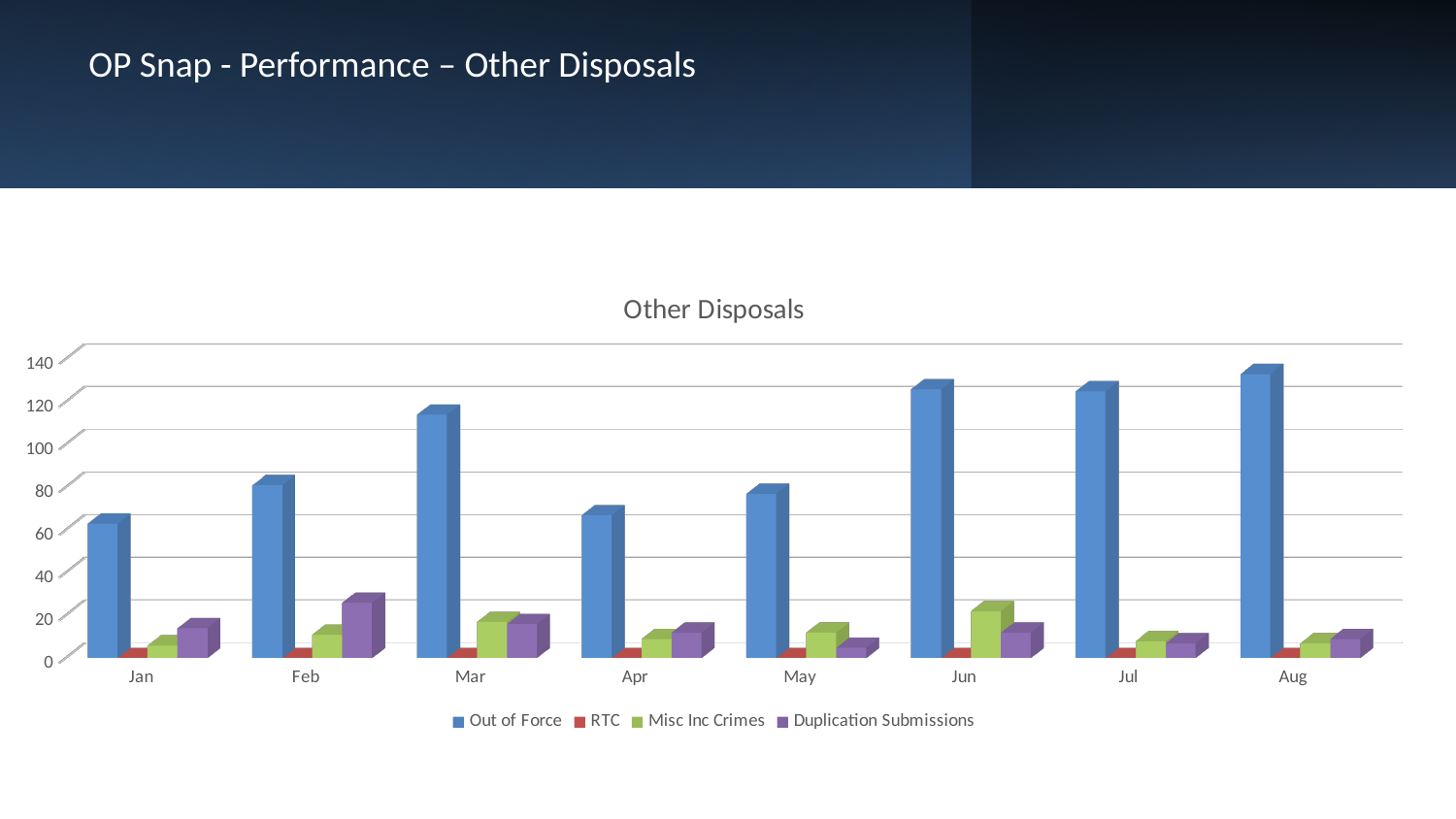
Is the Out of Force value for Apr greater or less than 80? less In which month is the Misc Inc Crimes value highest? Jun What is the title of the chart? Other Disposals In which month is the Out of Force value highest? Aug What type of chart is shown on the slide? Bar chart In which month is the Duplication Submissions value highest? Feb How many months are shown on the x axis? 8 Which is larger, the Out of Force value for Mar or for Apr? Mar Which series is shown in blue in the legend? Out of Force How many series does the legend list? 4 Is the Out of Force value for Aug greater or less than 120? greater Is the Out of Force value for Mar greater or less than 100? greater